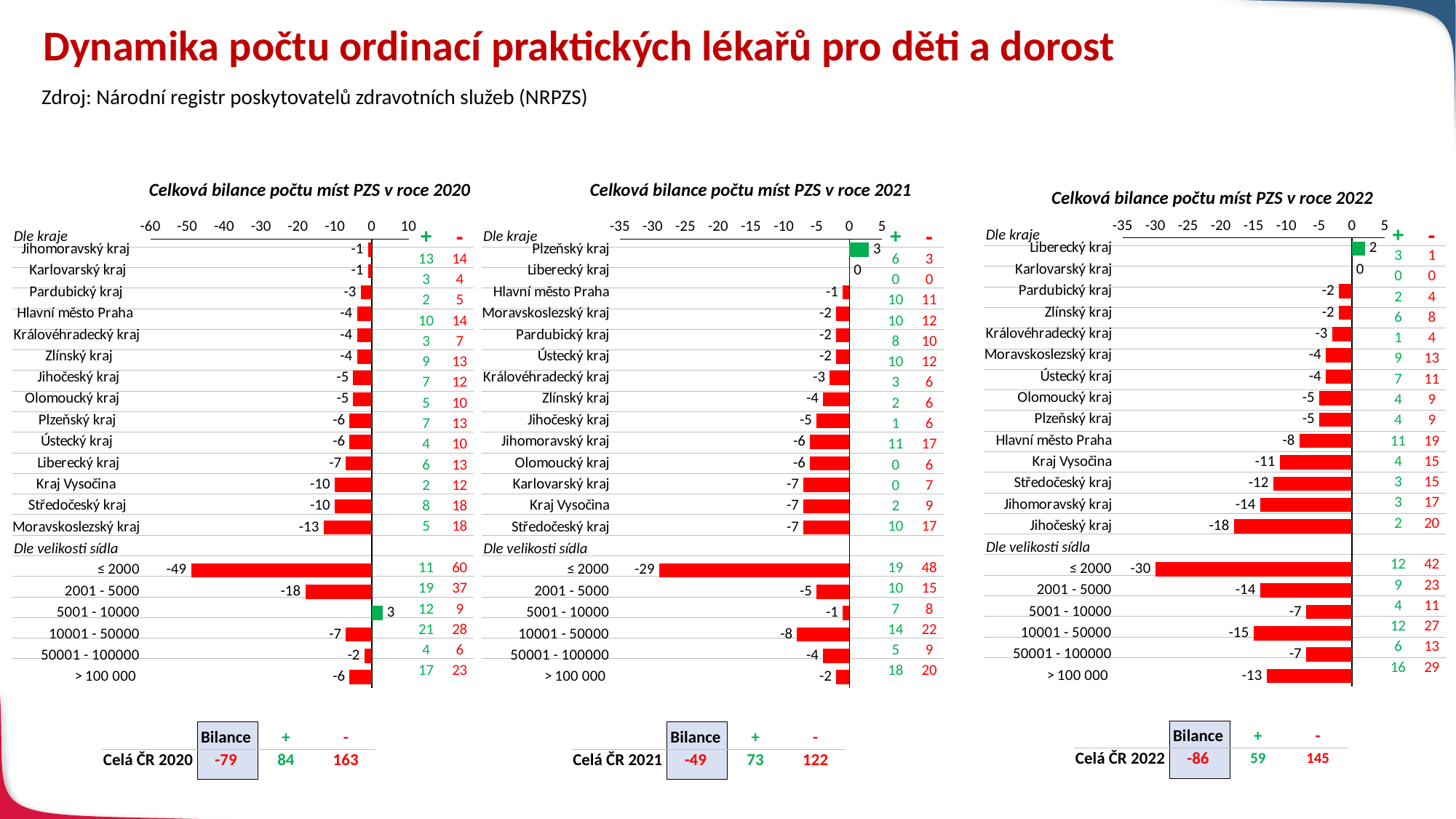
In the chart 'Celková bilance počtu míst PZS v roce 2020', which settlement size category has the only positive value? 5001 - 10000 In the chart 'Celková bilance počtu míst PZS v roce 2022', which region (kraj) has the lowest value? Jihočeský kraj In the chart 'Celková bilance počtu míst PZS v roce 2021', what is the value for Plzeňský kraj? 3 In the chart 'Celková bilance počtu míst PZS v roce 2022', what is the value for Kraj Vysočina? -11 In the chart 'Celková bilance počtu míst PZS v roce 2022', which is larger, the value for 10001 - 50000 or the value for > 100 000? > 100 000 In the chart 'Celková bilance počtu míst PZS v roce 2021', which settlement size category has the lowest value? ≤ 2000 In the chart 'Celková bilance počtu míst PZS v roce 2022', what is the difference between the values for ≤ 2000 and 2001 - 5000? 16 What kind of chart is 'Celková bilance počtu míst PZS v roce 2020'? Bar chart In the chart 'Celková bilance počtu míst PZS v roce 2021', what is the difference between the values for Středočeský kraj and Hlavní město Praha? 6 How many regions (kraje) are listed in the chart 'Celková bilance počtu míst PZS v roce 2021'? 14 In the chart 'Celková bilance počtu míst PZS v roce 2020', what is the value for Moravskoslezský kraj? -13 In the chart 'Celková bilance počtu míst PZS v roce 2020', what is the value for the settlement size category ≤ 2000? -49